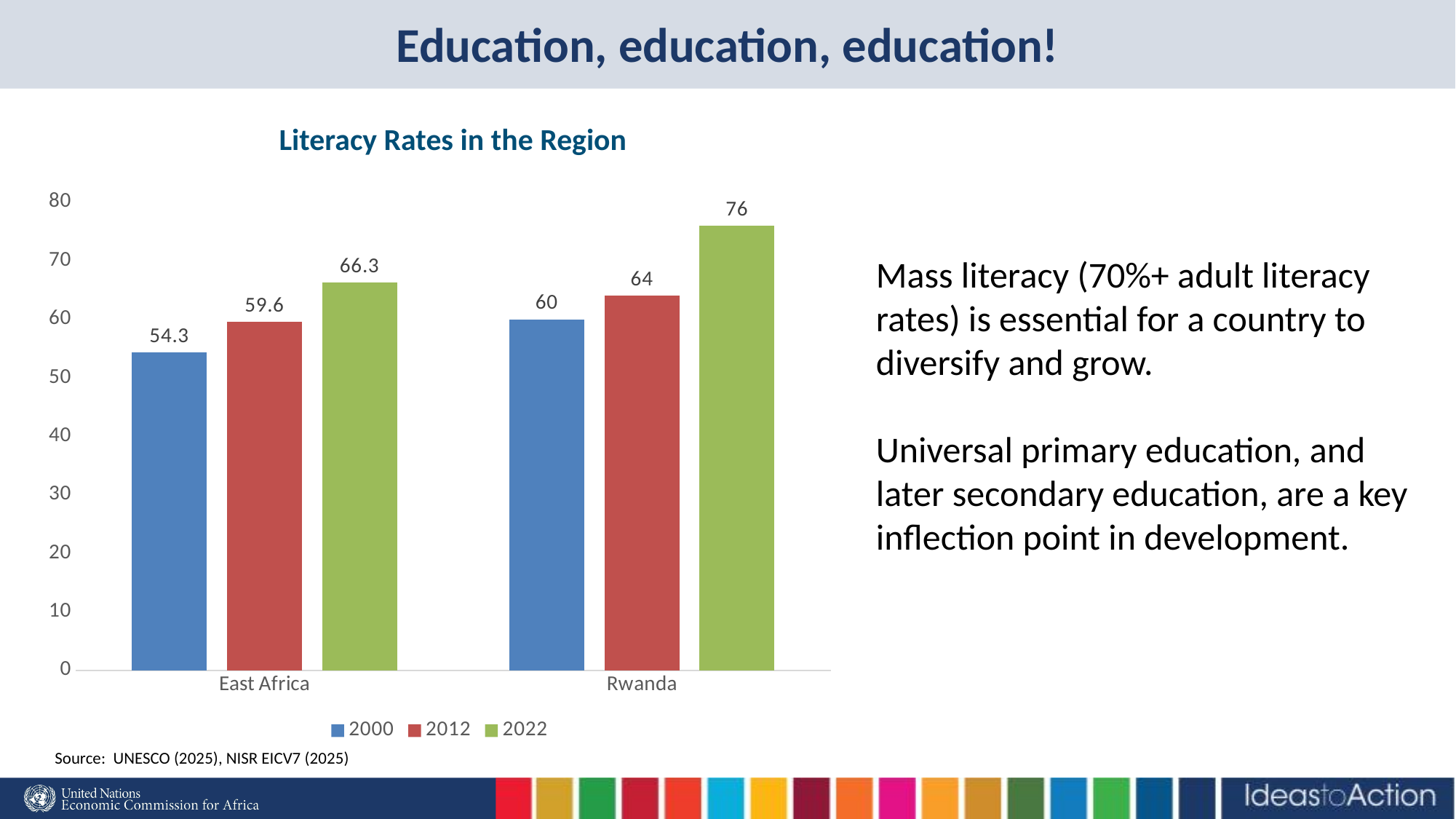
What is the literacy rate for Rwanda in 2012? 64 How many series does the legend list? 3 What kind of chart is shown on the slide? Bar chart What is the literacy rate for Rwanda in 2022? 76 What is the title of the chart? Literacy Rates in the Region What is the literacy rate for East Africa in 2000? 54.3 Which category has the highest 2022 literacy rate? Rwanda What is the literacy rate for East Africa in 2012? 59.6 What is the difference between Rwanda's and East Africa's literacy rates in 2022? 9.7 Which category has the lowest 2000 literacy rate? East Africa Which is larger, Rwanda's 2000 literacy rate or East Africa's 2012 literacy rate? Rwanda's 2000 literacy rate By how much did East Africa's literacy rate increase from 2000 to 2022? 12